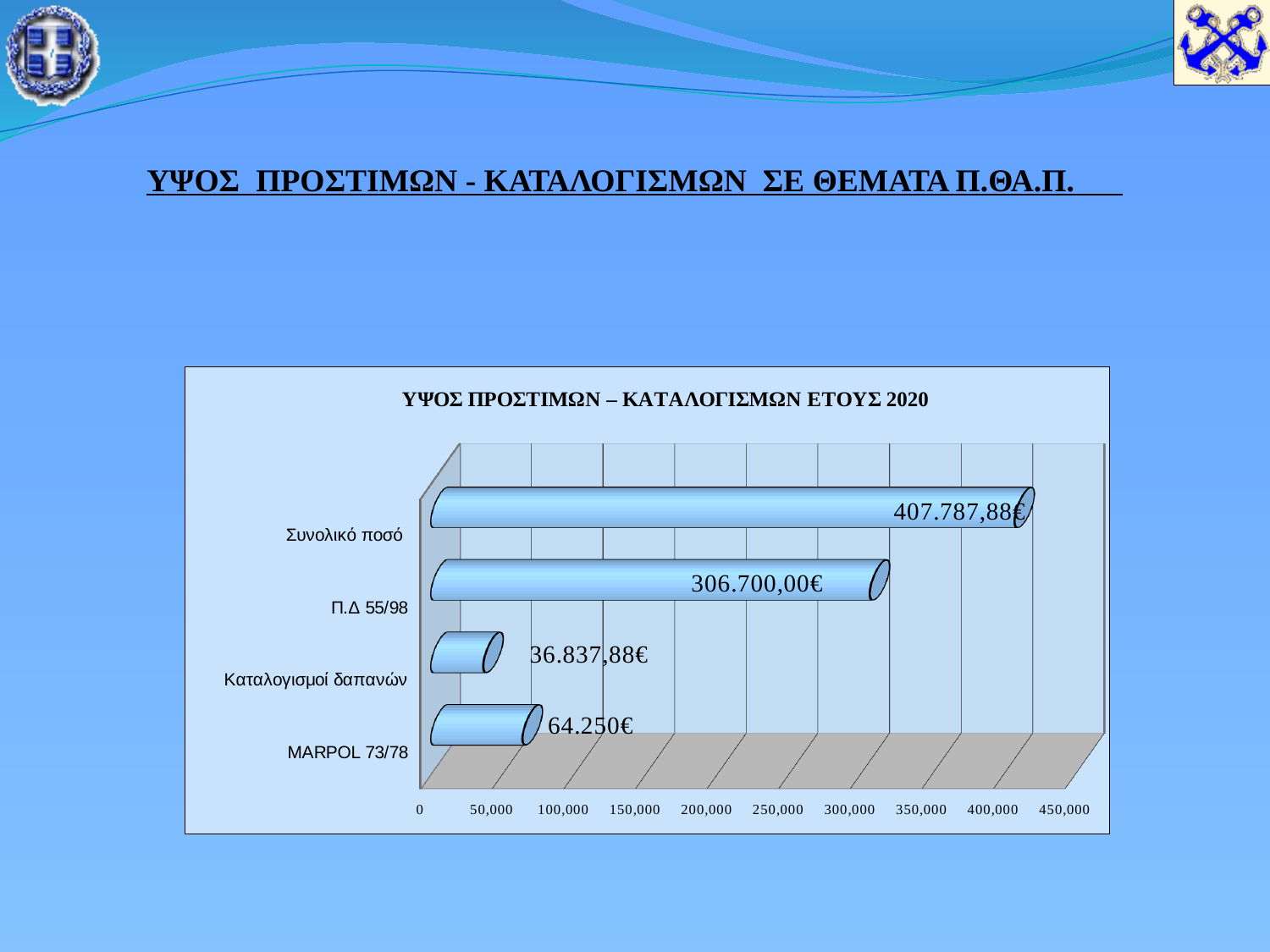
Which is larger, the value for MARPOL 73/78 or the value for Καταλογισμοί δαπανών? MARPOL 73/78 What is the value for Συνολικό ποσό? 407.787,88€ How many categories are shown in the chart? 4 What type of chart is shown on the slide? Bar chart Which category has the lowest value? Καταλογισμοί δαπανών What is the value for Καταλογισμοί δαπανών? 36.837,88€ Which category has the highest value? Συνολικό ποσό What is the title of the chart? ΥΨΟΣ ΠΡΟΣΤΙΜΩΝ – ΚΑΤΑΛΟΓΙΣΜΩΝ ΕΤΟΥΣ 2020 What is the value for Π.Δ 55/98? 306.700,00€ What is the difference between the value for Π.Δ 55/98 and the value for MARPOL 73/78? 242.450,00€ What is the value for MARPOL 73/78? 64.250€ Is the value for Π.Δ 55/98 greater or less than 300,000? greater